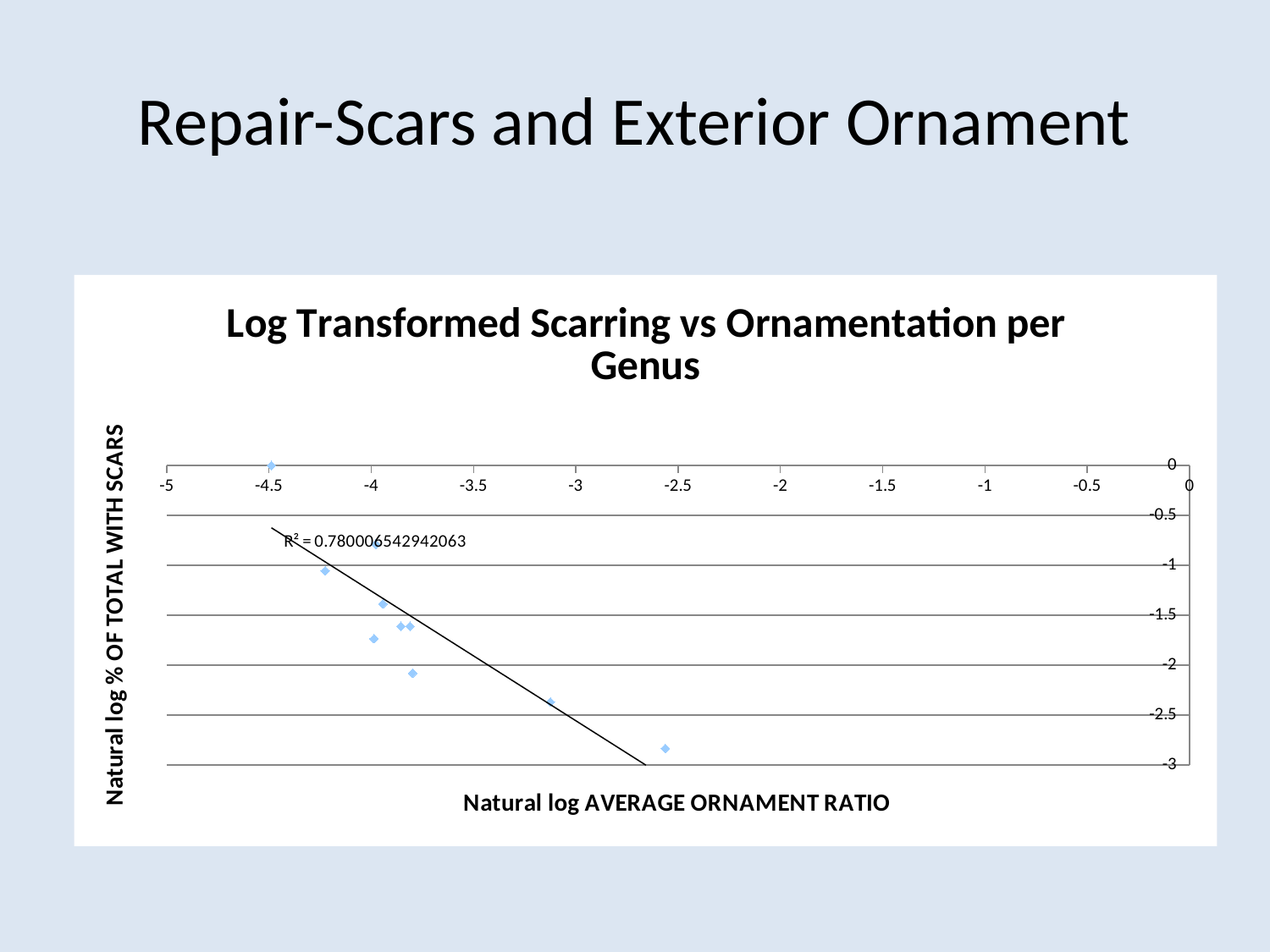
What is the label of the x axis? Natural log AVERAGE ORNAMENT RATIO Does the trendline slope upward or downward from left to right? downward Is the y value of the lowest plotted point greater or less than -3? greater What is the title of the chart? Log Transformed Scarring vs Ornamentation per Genus What kind of chart is shown on the slide? scatter chart Is the y value of the rightmost point (near x = -2.5) greater or less than -2.5? less What is the y value of the highest plotted point, which lies on the top gridline? 0 As the natural log average ornament ratio increases along the x axis, do the plotted values rise or fall? fall What is the R² value printed on the chart? 0.780006542942063 Is the y value of the point near x = -4 that lies closest to the top greater or less than -1? greater